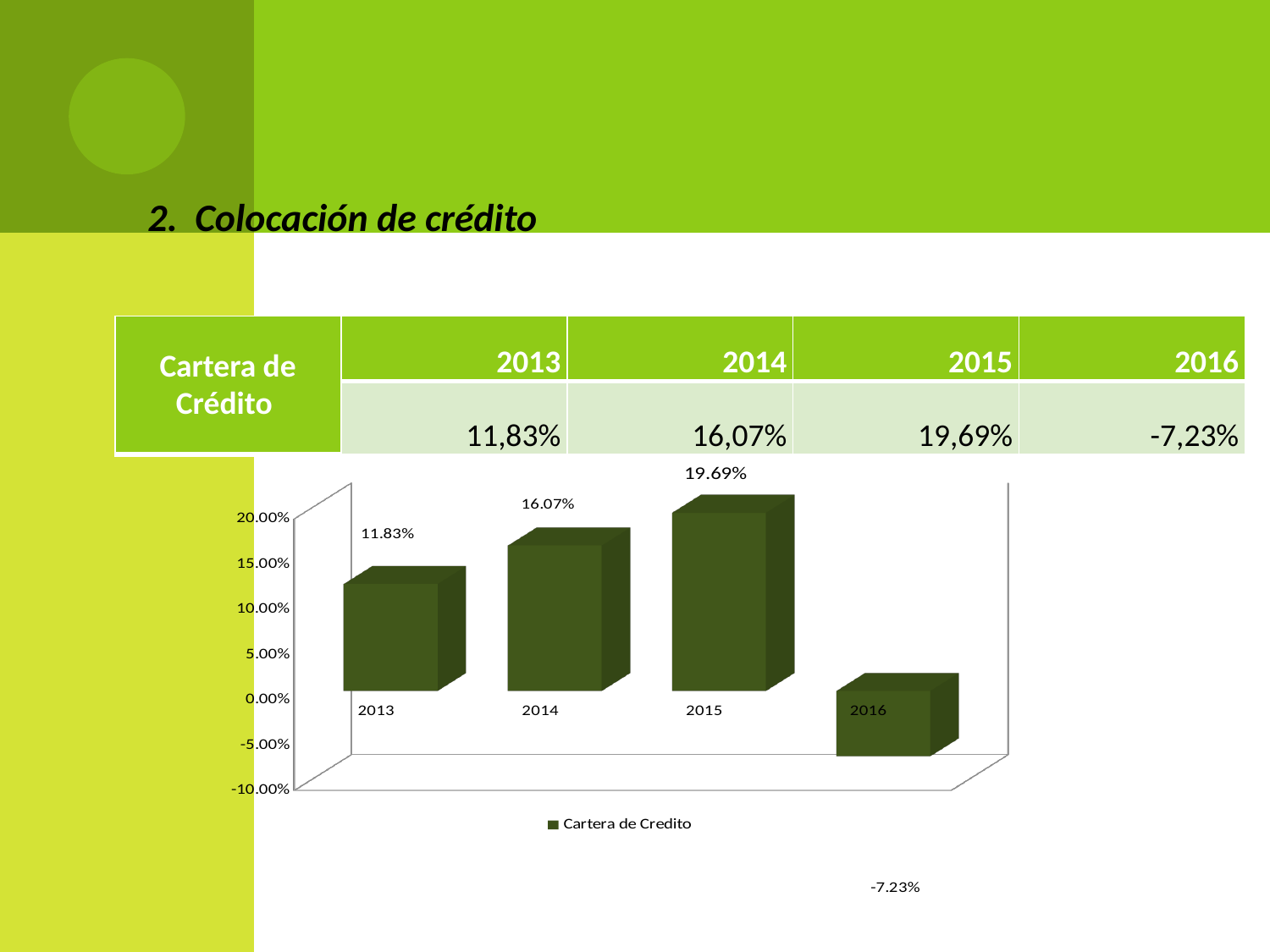
What is the difference between the values for 2015 and 2013? 7.86% What kind of chart is shown on the slide? Bar chart How many series does the chart legend list? 1 Which year has the highest value in the chart? 2015 What is the value for 2015 in the chart? 19.69% What is the value for 2016 in the chart? -7.23% Which is larger, the value for 2014 or the value for 2015? 2015 Which year has the lowest value in the chart? 2016 How many years are shown on the x axis of the chart? 4 What is the value for 2013 in the chart? 11.83% What is the name of the series in the chart legend? Cartera de Credito What is the difference between the values for 2014 and 2013? 4.24%